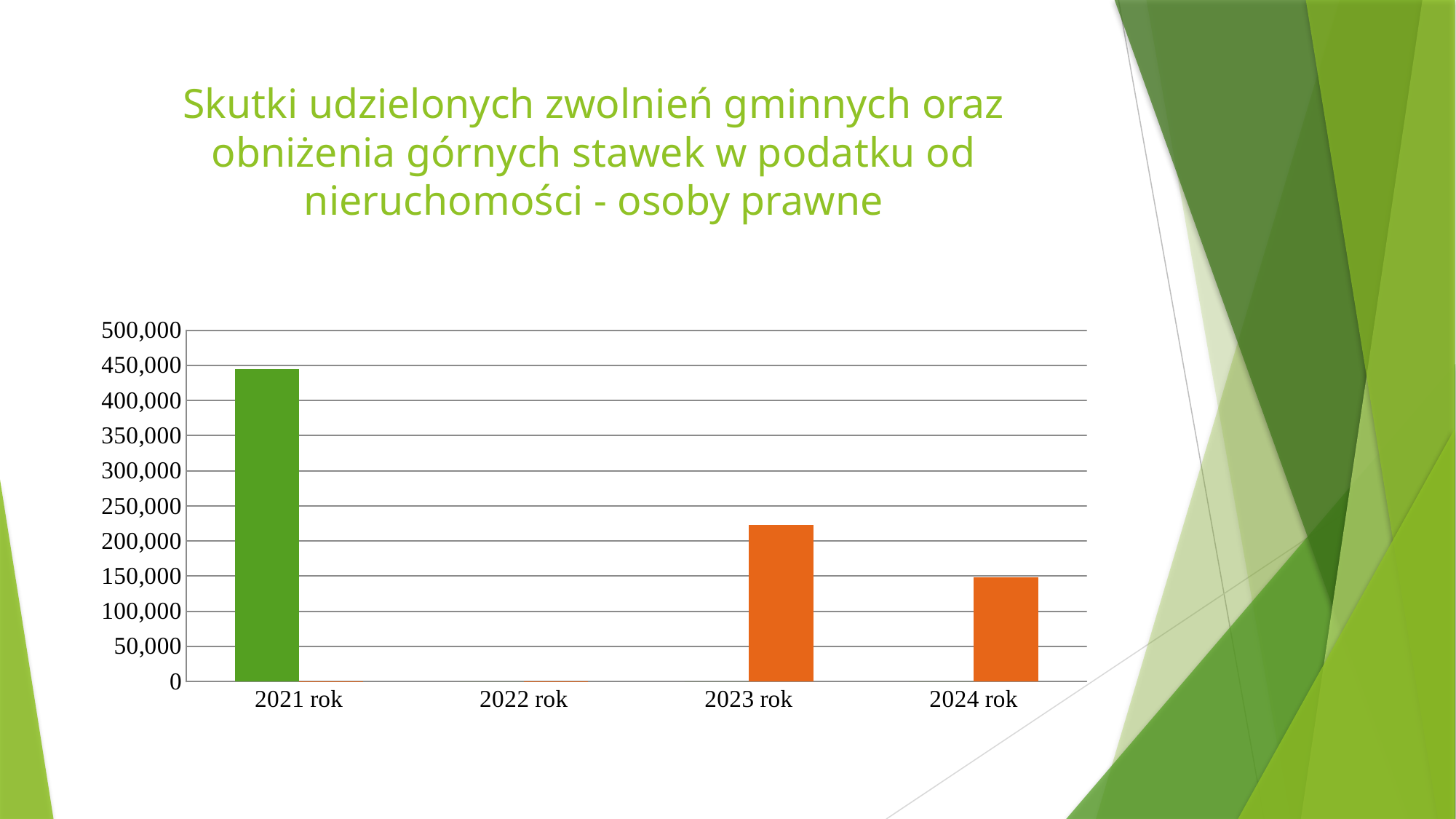
Is the value for 2021 rok greater or less than 400,000? greater Is the value for 2024 rok greater or less than 100,000? greater Which is larger, the value for 2023 rok or the value for 2024 rok? 2023 rok How many year categories are shown on the x axis of the chart? 4 What colour is the bar for 2021 rok? green Is the value for 2023 rok greater or less than 250,000? less Which year has the lowest value in the chart? 2022 rok Which is larger, the value for 2021 rok or the value for 2023 rok? 2021 rok What kind of chart is shown on the slide? bar chart Which year has the highest value in the chart? 2021 rok Does the value rise or fall from 2023 rok to 2024 rok? fall